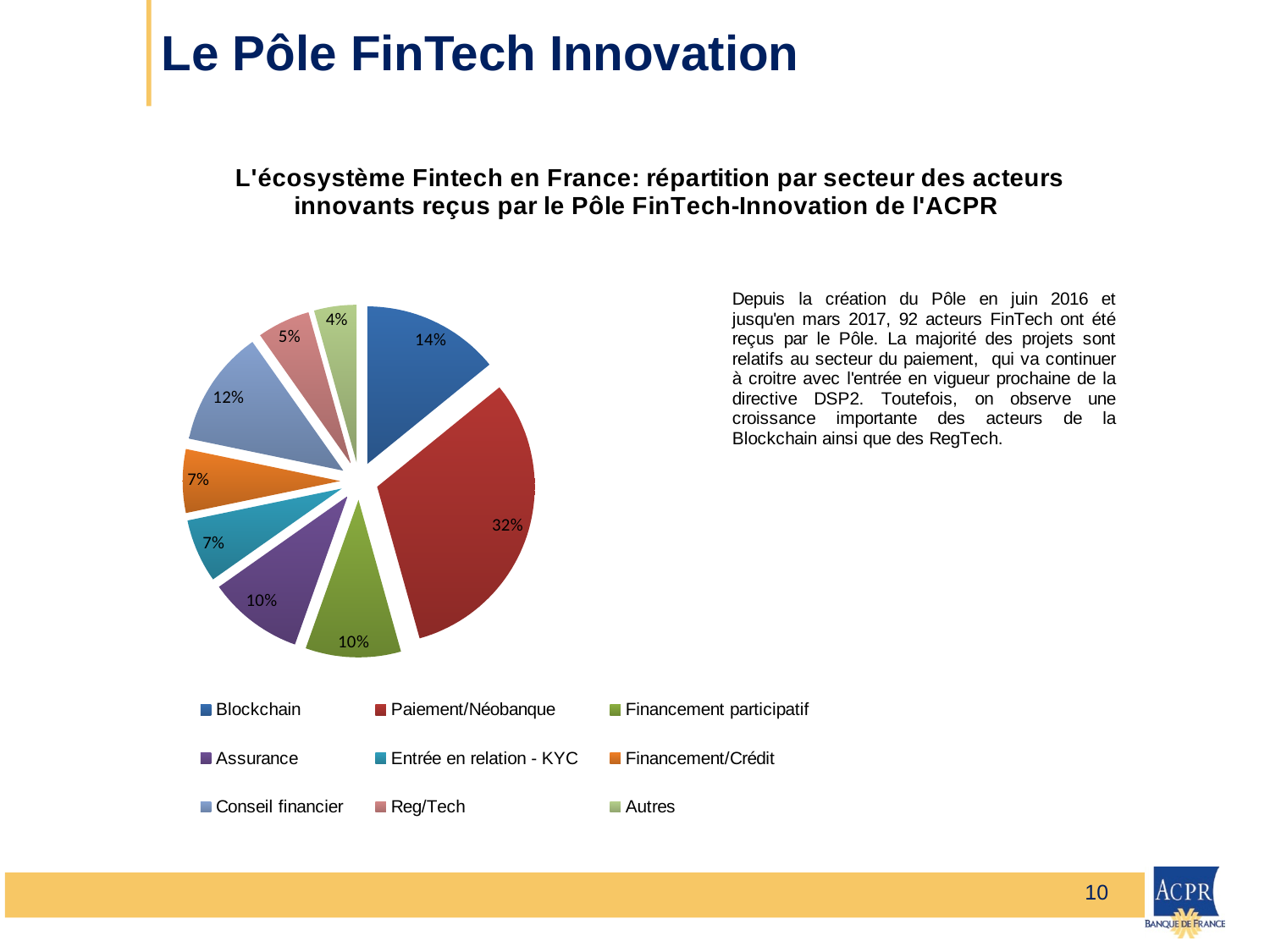
How many entries does the legend list? 9 What kind of chart is shown on the slide? pie chart What colour is the slice for Financement/Crédit? orange Which category has the largest slice of the pie? Paiement/Néobanque Which is larger, the share for Conseil financier or the share for Assurance? Conseil financier What share of the pie does Paiement/Néobanque represent? 32% How many categories does the pie chart have? 9 What is the value shown for Conseil financier? 12% What is the difference between the shares of Paiement/Néobanque and Blockchain? 18% What is the value shown for Reg/Tech? 5% Which category has the smallest slice of the pie? Autres What is the value shown for Blockchain? 14%